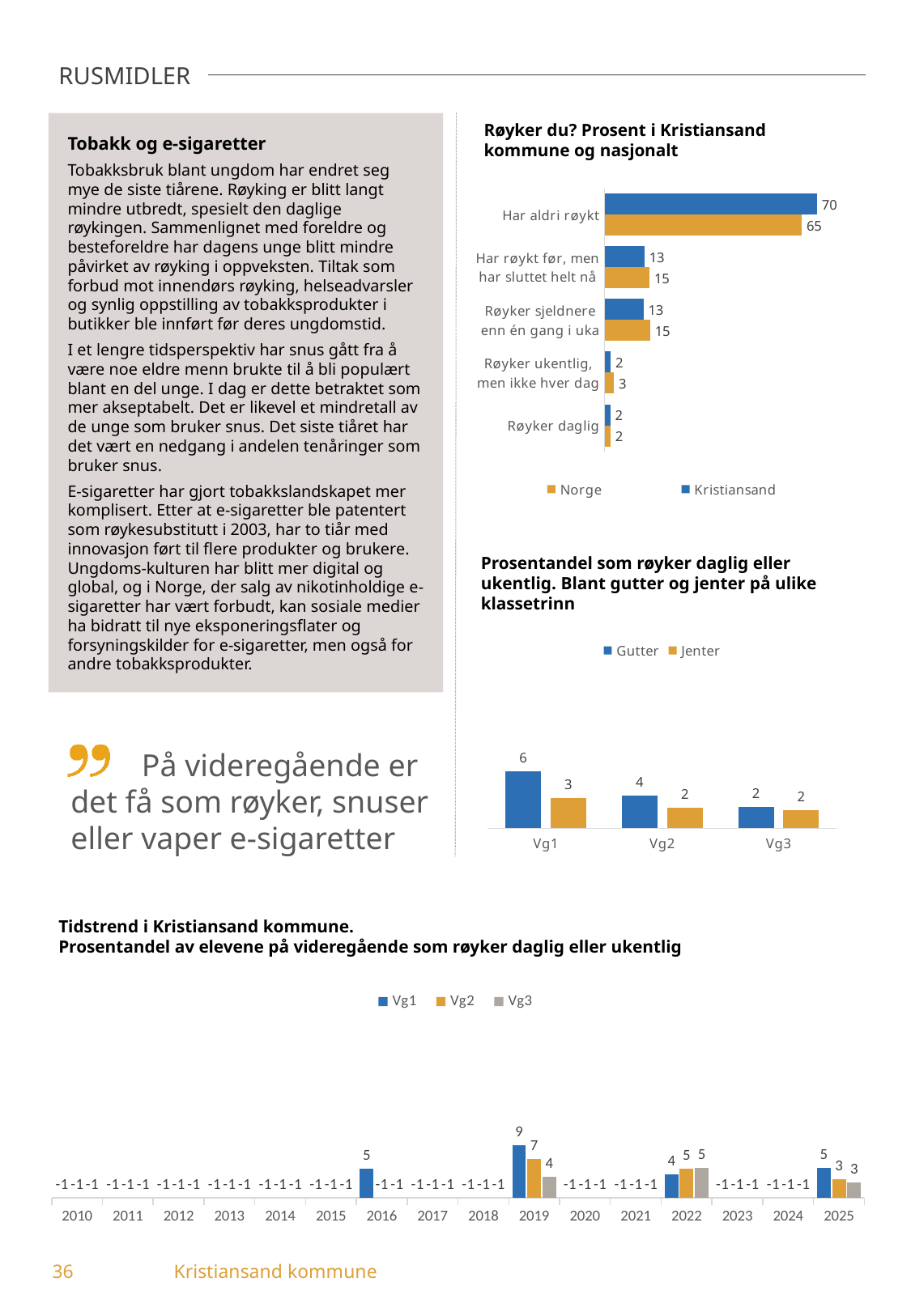
In the chart 'Prosentandel som røyker daglig eller ukentlig', how many class levels are shown on the x axis? 3 In the chart 'Tidstrend i Kristiansand kommune', what is the value for Vg1 in 2019? 9 In the chart 'Røyker du? Prosent i Kristiansand kommune og nasjonalt', what is the difference between the Kristiansand and Norge values for 'Har aldri røykt'? 5 In the chart 'Røyker du? Prosent i Kristiansand kommune og nasjonalt', what is the value for Norge for 'Har røykt før, men har sluttet helt nå'? 15 In the chart 'Tidstrend i Kristiansand kommune', what is the difference between the Vg1 and Vg3 values in 2025? 2 In the chart 'Røyker du? Prosent i Kristiansand kommune og nasjonalt', how many series does the legend list? 2 In the chart 'Tidstrend i Kristiansand kommune', what is the value for Vg3 in 2022? 5 In the chart 'Røyker du? Prosent i Kristiansand kommune og nasjonalt', which category has the highest value for Kristiansand? Har aldri røykt In the chart 'Røyker du? Prosent i Kristiansand kommune og nasjonalt', what is the value for Kristiansand for 'Har aldri røykt'? 70 What kind of chart is 'Røyker du? Prosent i Kristiansand kommune og nasjonalt'? Bar chart In the chart 'Prosentandel som røyker daglig eller ukentlig', which is larger at Vg2: Gutter or Jenter? Gutter In the chart 'Prosentandel som røyker daglig eller ukentlig', what is the value for Gutter at Vg1? 6